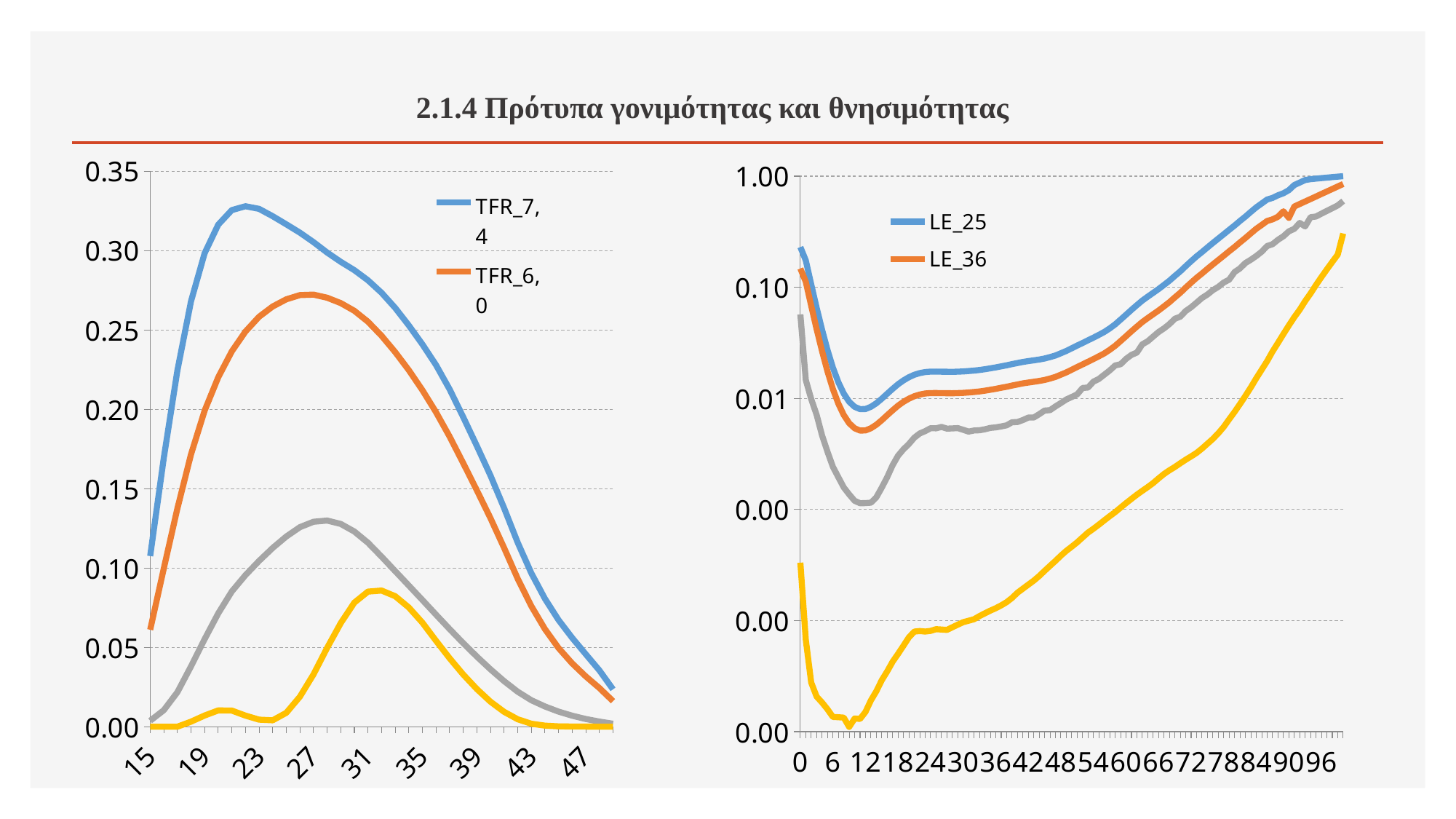
In the right chart, does the LE_25 line rise or fall between x = 24 and x = 96? rise In the left chart, is the peak value of the TFR_6,0 line greater or less than 0.30? less How many series does the legend of the left chart list? 2 How many series does the legend of the right chart list? 2 How many lines are plotted in the right chart? 4 In the left chart, does the TFR_7,4 line rise or fall between age 23 and age 47? fall What kind of chart is the left chart on the slide? line chart In the right chart, is the value of the LE_36 line at x = 12 greater or less than 0.01? less In the left chart, is the value of the TFR_7,4 line at age 23 greater or less than 0.30? greater In the right chart, at x = 48, which line is higher: LE_25 or LE_36? LE_25 In the left chart, at age 27, which line is higher: TFR_7,4 or TFR_6,0? TFR_7,4